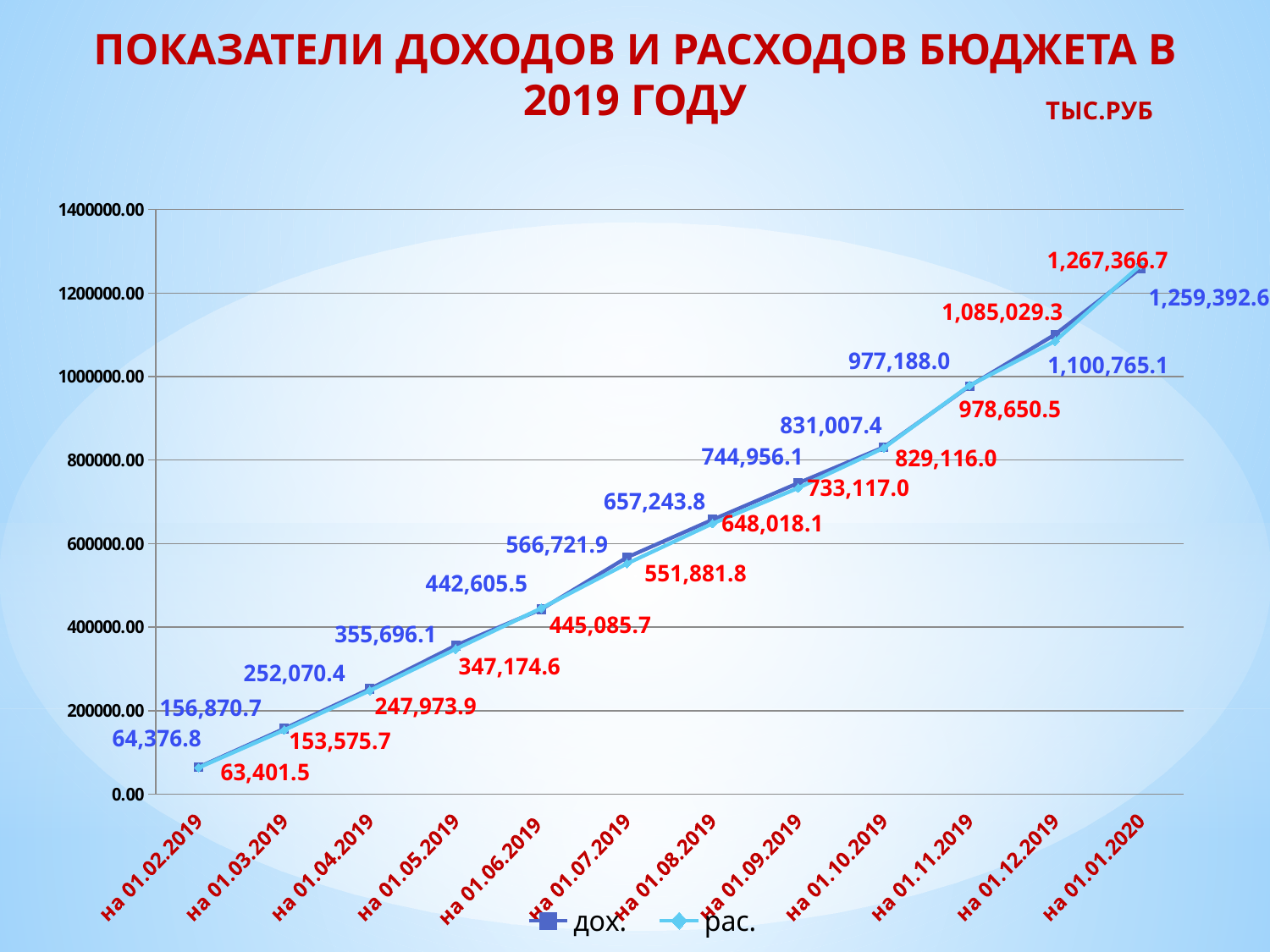
What is the value of рас. на 01.06.2019? 445,085.7 What is the difference between рас. and дох. на 01.01.2020? 7,974.1 What type of chart is shown on the slide? line chart Do the values of дох. rise or fall from 01.02.2019 to 01.01.2020? rise What is the value of рас. на 01.01.2020? 1,267,366.7 How many dates are plotted along the x axis? 12 How many series does the legend list? 2 At which date is рас. at its lowest value? на 01.02.2019 At which date does дох. reach its highest value? на 01.01.2020 What is the value of дох. на 01.02.2019? 64,376.8 Which is larger на 01.09.2019, дох. or рас.? дох. What is the value of дох. на 01.12.2019? 1,100,765.1